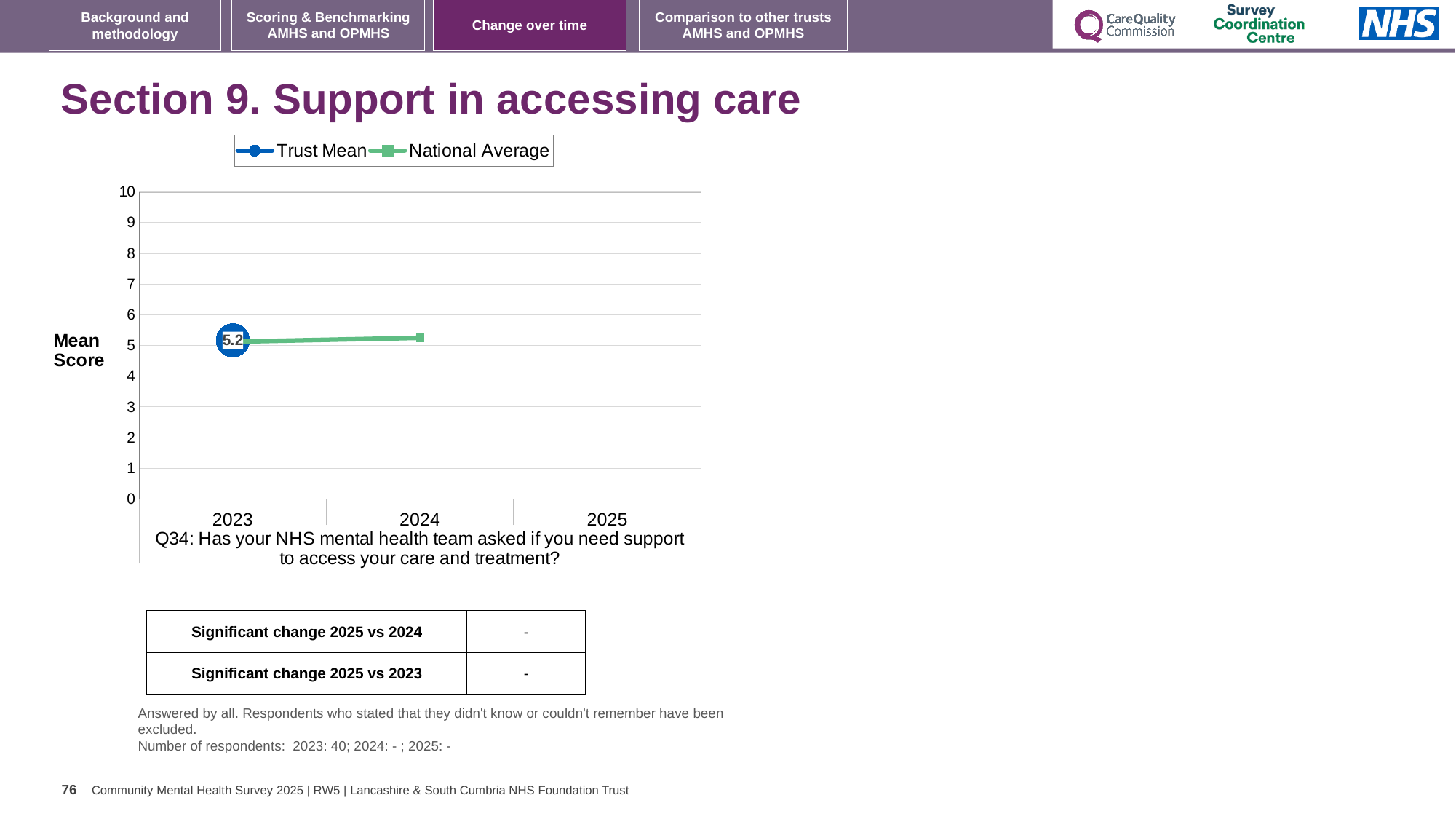
What is the Trust Mean value for 2023? 5.2 What are the two series named in the legend? Trust Mean and National Average What is the highest value shown on the y axis? 10 Is the Trust Mean value for 2023 greater or less than 8? less Is the National Average value for 2024 greater or less than 7? less Does the National Average line rise or fall from 2023 to 2024? rise What is the label on the y axis of the chart? Mean Score For which year is a Trust Mean data label printed on the chart? 2023 Is the National Average value for 2024 greater or less than 4? greater What kind of chart is shown on the slide? line chart How many years are shown on the x axis? 3 How many series does the legend list? 2